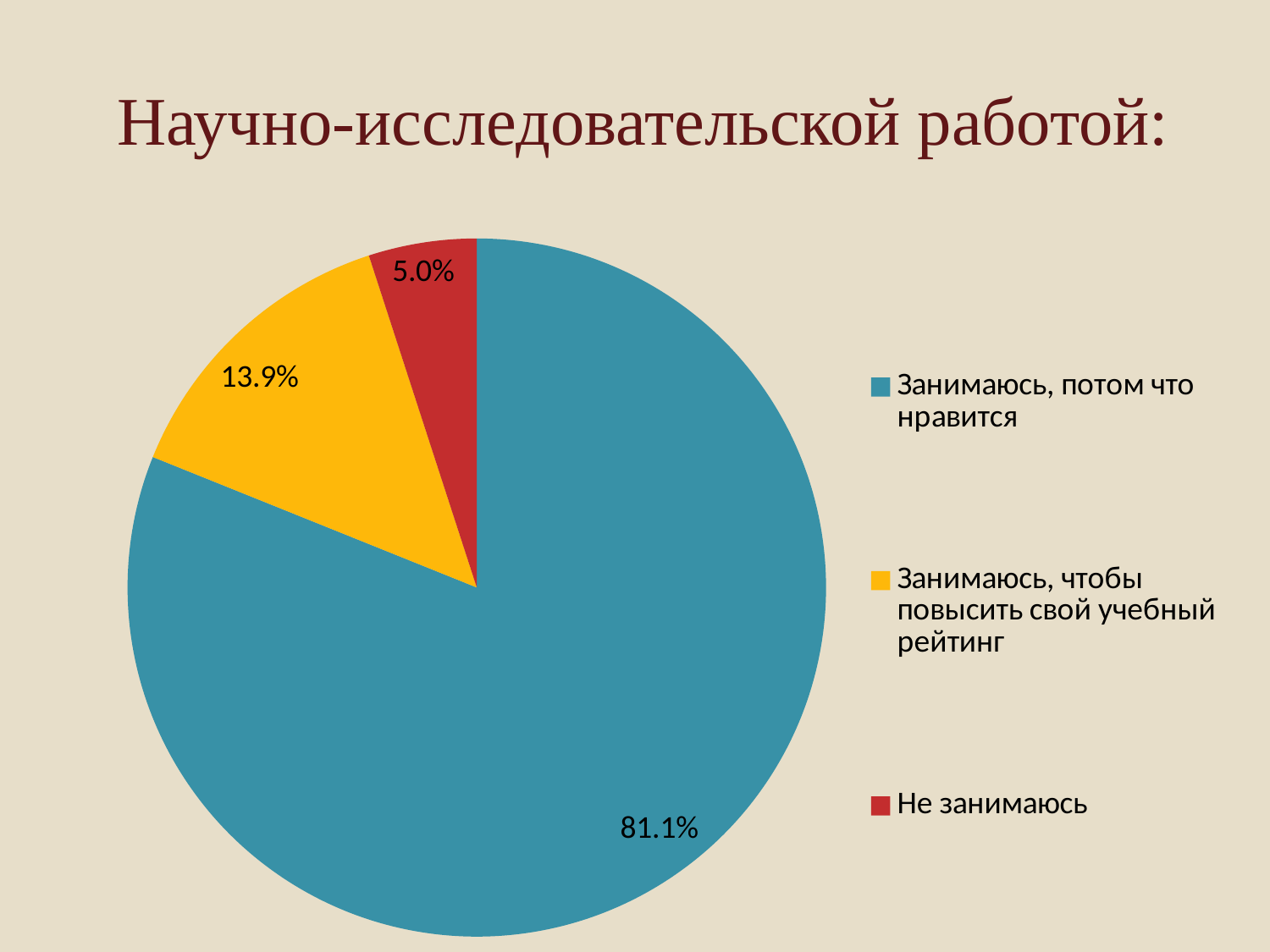
How many entries does the legend list? 3 What share of the pie is labelled "Занимаюсь, потом что нравится"? 81.1% What is the difference between the shares for "Занимаюсь, чтобы повысить свой учебный рейтинг" and "Не занимаюсь"? 8.9% How many slices does the pie chart have? 3 What colour is the slice for "Не занимаюсь"? red Which category has the smallest slice of the pie? Не занимаюсь Which category has the largest slice of the pie? Занимаюсь, потом что нравится What kind of chart is shown on the slide? pie chart Which is larger: the share for "Занимаюсь, чтобы повысить свой учебный рейтинг" or the share for "Не занимаюсь"? Занимаюсь, чтобы повысить свой учебный рейтинг What share of the pie is labelled "Не занимаюсь"? 5.0% What is the difference between the shares for "Занимаюсь, потом что нравится" and "Занимаюсь, чтобы повысить свой учебный рейтинг"? 67.2% What share of the pie is labelled "Занимаюсь, чтобы повысить свой учебный рейтинг"? 13.9%